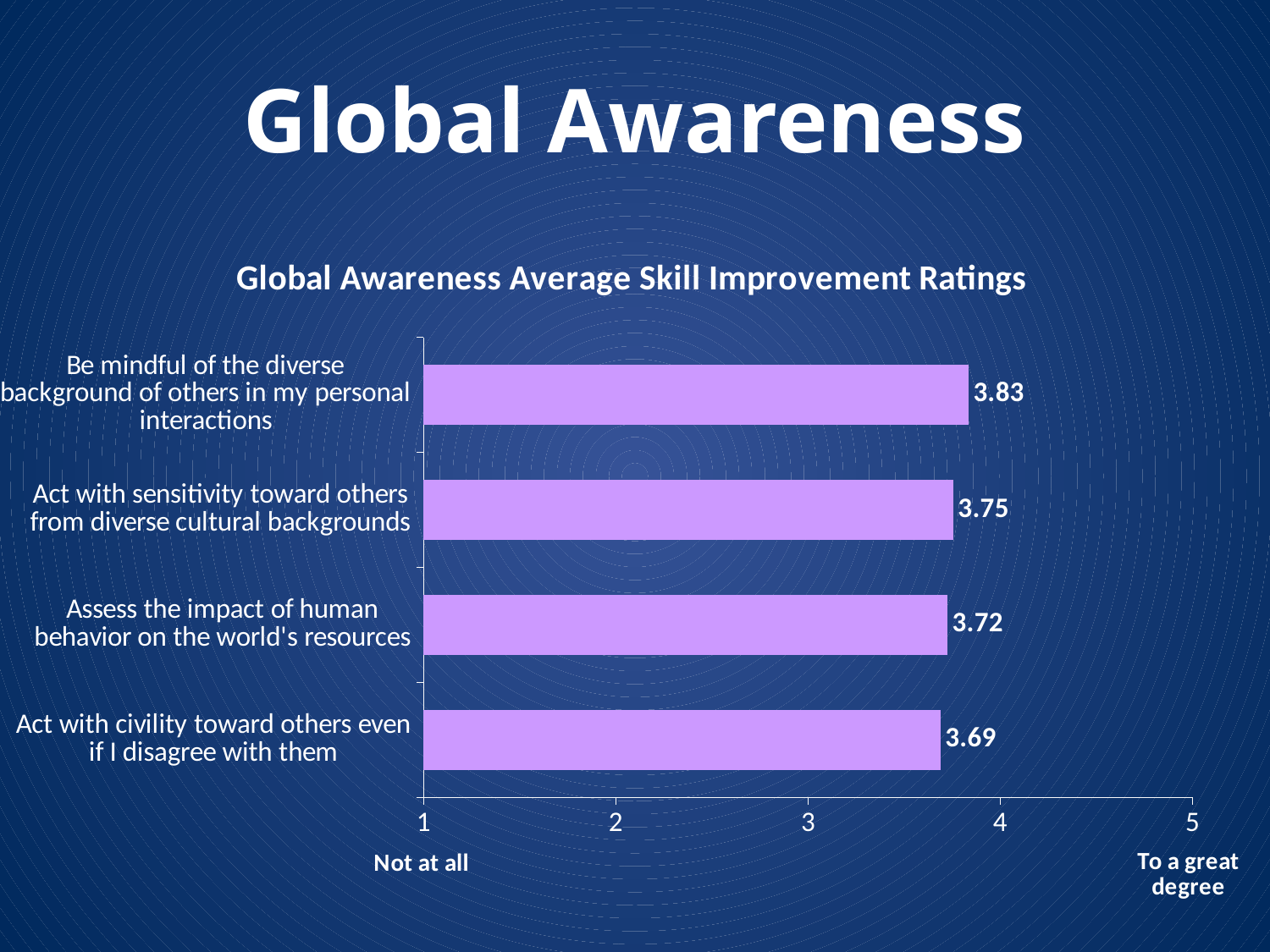
What is the average skill improvement rating for "Be mindful of the diverse background of others in my personal interactions"? 3.83 What is the rating for "Act with civility toward others even if I disagree with them"? 3.69 How many items are rated in the chart? 4 Is the rating for "Be mindful of the diverse background of others in my personal interactions" greater or less than 4? less What type of chart is shown on the slide? bar chart What is the difference between the ratings for "Act with sensitivity toward others from diverse cultural backgrounds" and "Assess the impact of human behavior on the world's resources"? 0.03 Which item has the lowest average skill improvement rating? Act with civility toward others even if I disagree with them What is the difference between the highest and lowest ratings shown? 0.14 What is the title of the chart? Global Awareness Average Skill Improvement Ratings Which item has the highest average skill improvement rating? Be mindful of the diverse background of others in my personal interactions Which has a higher rating: "Act with sensitivity toward others from diverse cultural backgrounds" or "Act with civility toward others even if I disagree with them"? Act with sensitivity toward others from diverse cultural backgrounds What is the rating for "Assess the impact of human behavior on the world's resources"? 3.72